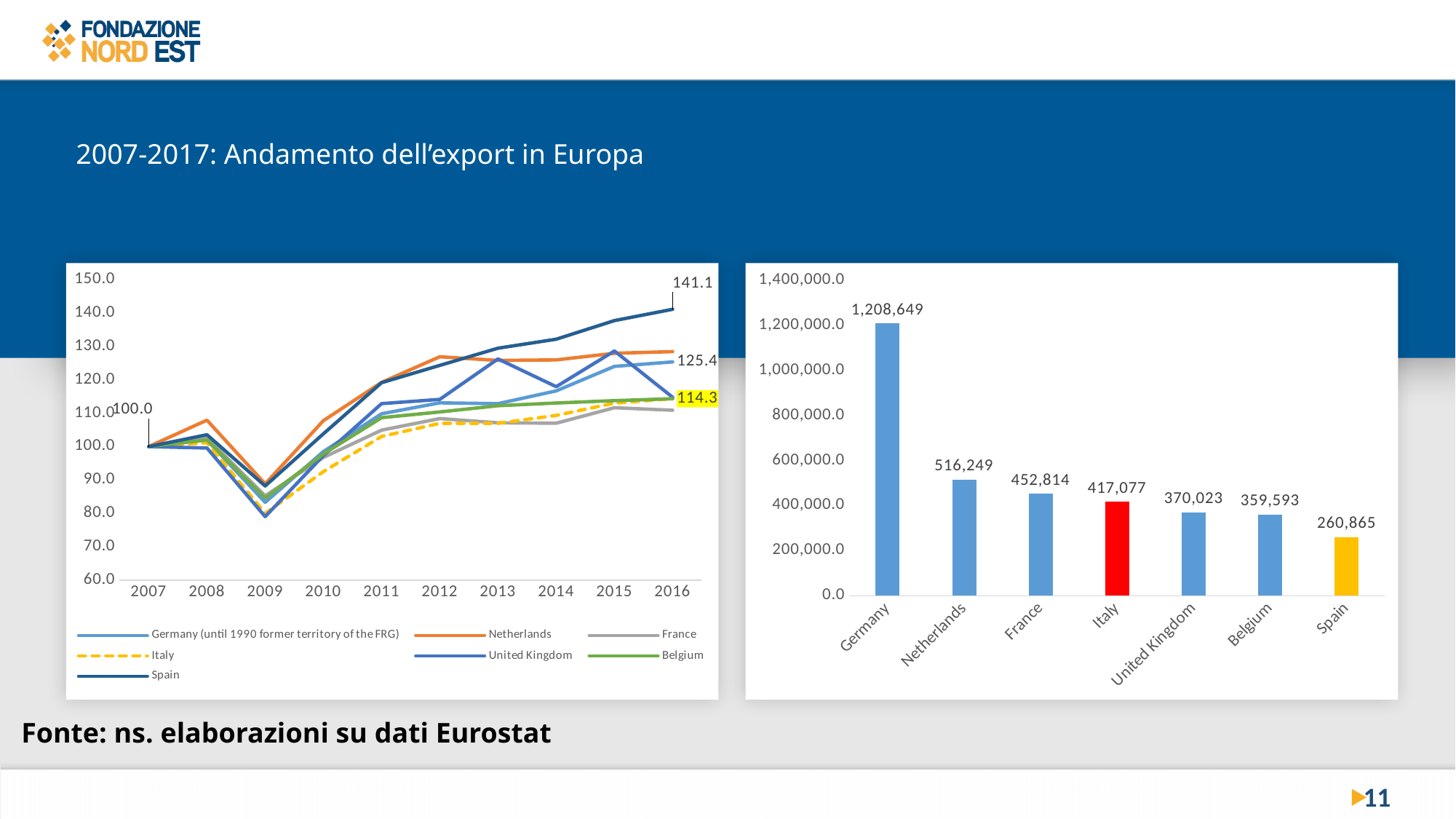
In the bar chart on the right, which country has the lowest value? Spain In the bar chart on the right, what is the value for Italy? 417,077 How many countries are shown in the bar chart on the right? 7 In the bar chart on the right, which bar is coloured red? Italy In the bar chart on the right, which country has the highest value? Germany In the bar chart on the right, what is the difference between the values for Netherlands and France? 63,435 What kind of chart is the chart on the left? Line chart In the line chart on the left, what is the value labelled for Spain in 2016? 141.1 How many series does the legend of the line chart on the left list? 7 In the bar chart on the right, what is the value for Germany? 1,208,649 In the line chart on the left, what is the highlighted value for Italy in 2016? 114.3 In the bar chart on the right, which is larger: the value for United Kingdom or the value for Belgium? United Kingdom